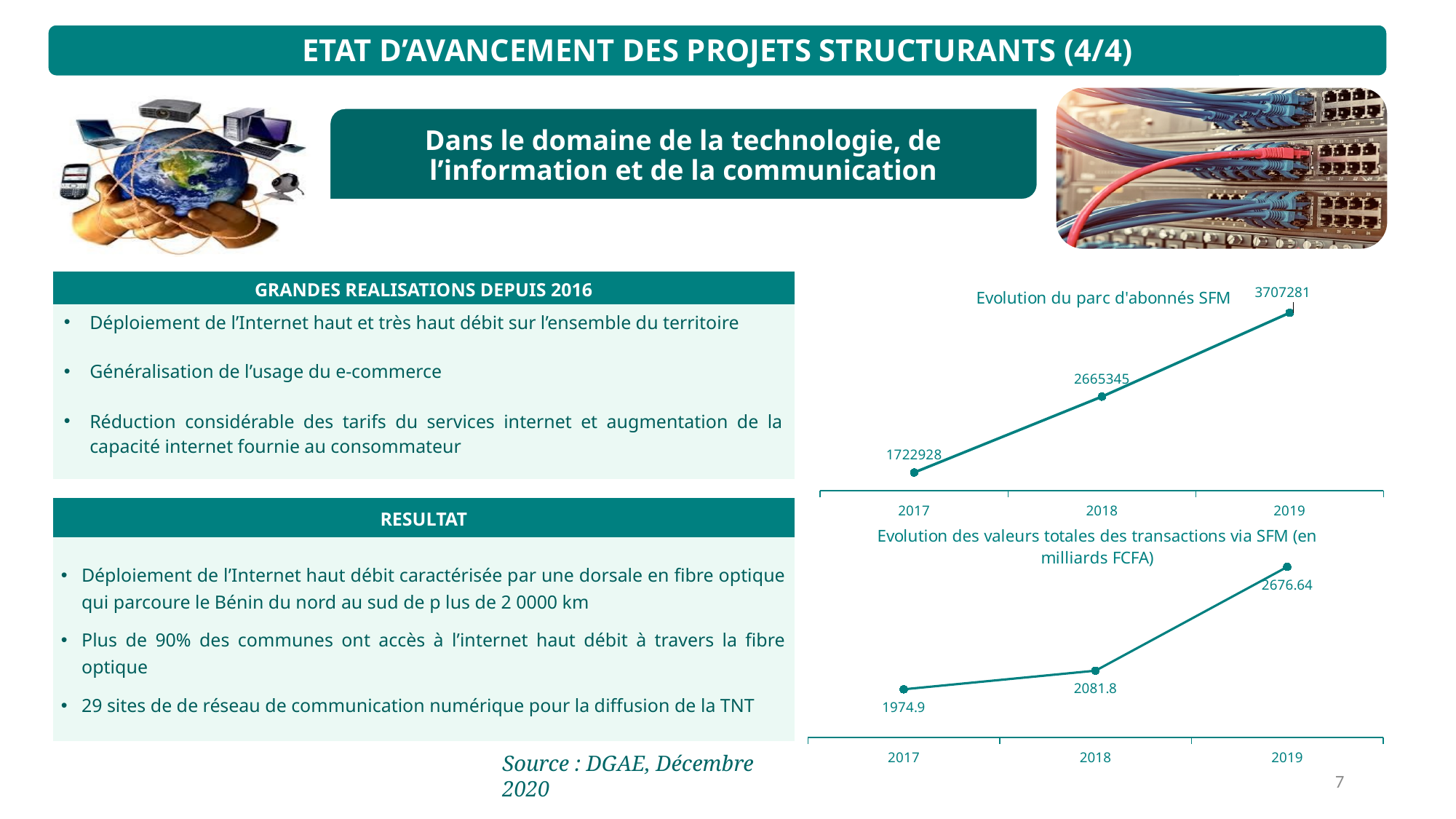
In the chart 'Evolution des valeurs totales des transactions via SFM', what is the value for 2019? 2676.64 In the chart 'Evolution du parc d'abonnés SFM', how many data points are plotted? 3 In the chart 'Evolution des valeurs totales des transactions via SFM', what is the difference between the 2019 and 2018 values? 594.84 In the chart 'Evolution du parc d'abonnés SFM', what is the difference between the 2018 and 2017 values? 942417 In the chart 'Evolution du parc d'abonnés SFM', what is the value for 2019? 3707281 In the chart 'Evolution des valeurs totales des transactions via SFM', which year has the lowest value? 2017 In the chart 'Evolution des valeurs totales des transactions via SFM', what is the value for 2018? 2081.8 In the chart 'Evolution du parc d'abonnés SFM', what is the value for 2017? 1722928 What kind of chart is 'Evolution du parc d'abonnés SFM'? line chart In the chart 'Evolution des valeurs totales des transactions via SFM', which is larger, the value for 2017 or the value for 2018? 2018 In the chart 'Evolution du parc d'abonnés SFM', which year has the highest value? 2019 In the chart 'Evolution du parc d'abonnés SFM', do the values rise or fall from 2017 to 2019? rise